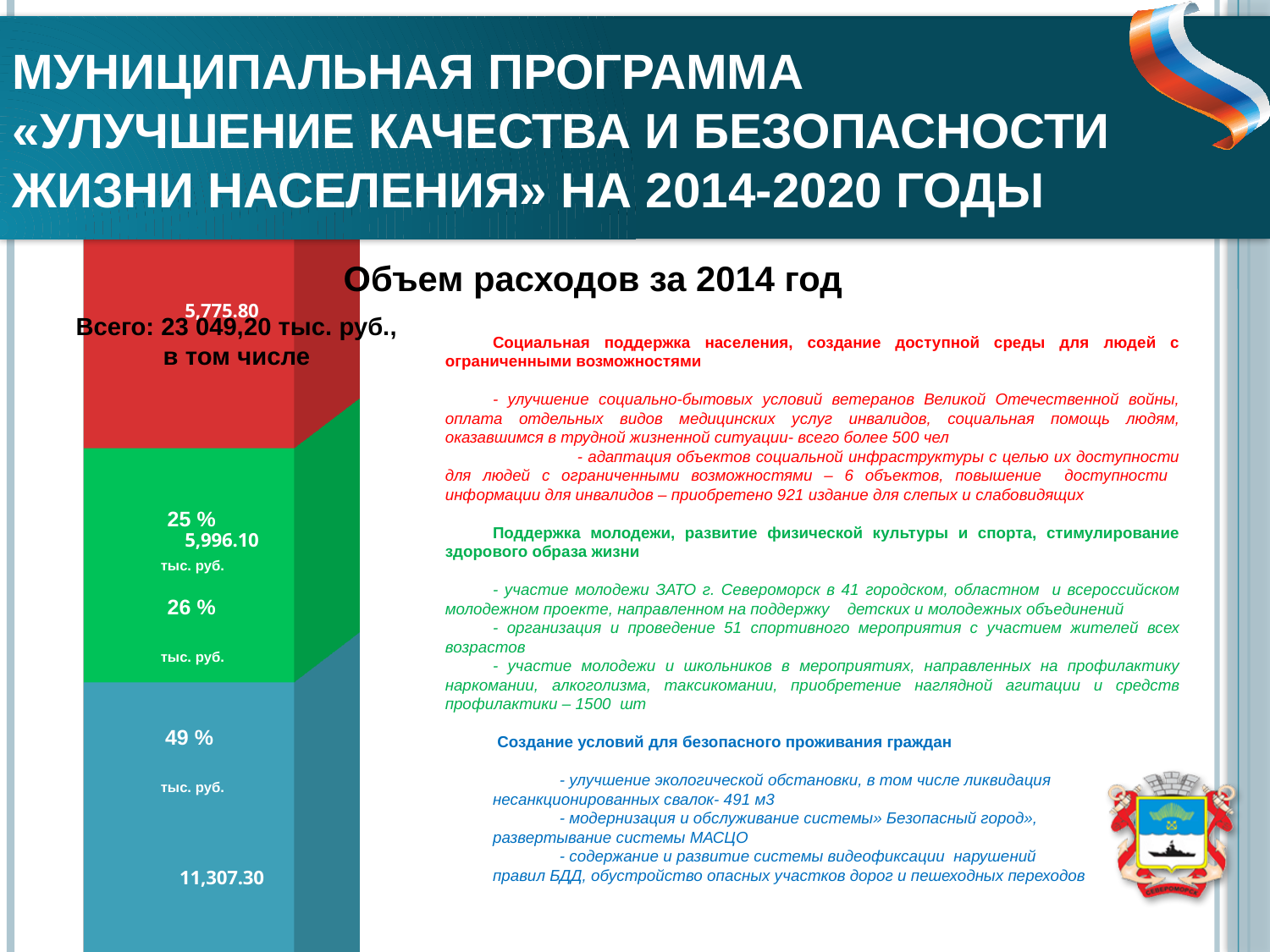
Which segment of the bar has the largest value? The blue segment (11,307.30) What is the difference between the blue segment value and the green segment value? 5,311.20 What kind of chart is shown on the left of the slide? A stacked bar chart What value is labelled on the green (middle) segment of the bar? 5,996.10 What total amount is stated above the chart? 23 049,20 тыс. руб. What value is labelled on the red (top) segment of the bar? 5,775.80 Which segment of the bar has the smallest value? The red segment (5,775.80) What is the title of the chart? Объем расходов за 2014 год What percentage share is shown for the green segment? 26 % What value is labelled on the blue (bottom) segment of the bar? 11,307.30 What percentage share is shown for the blue segment? 49 % How many segments make up the stacked bar? 3